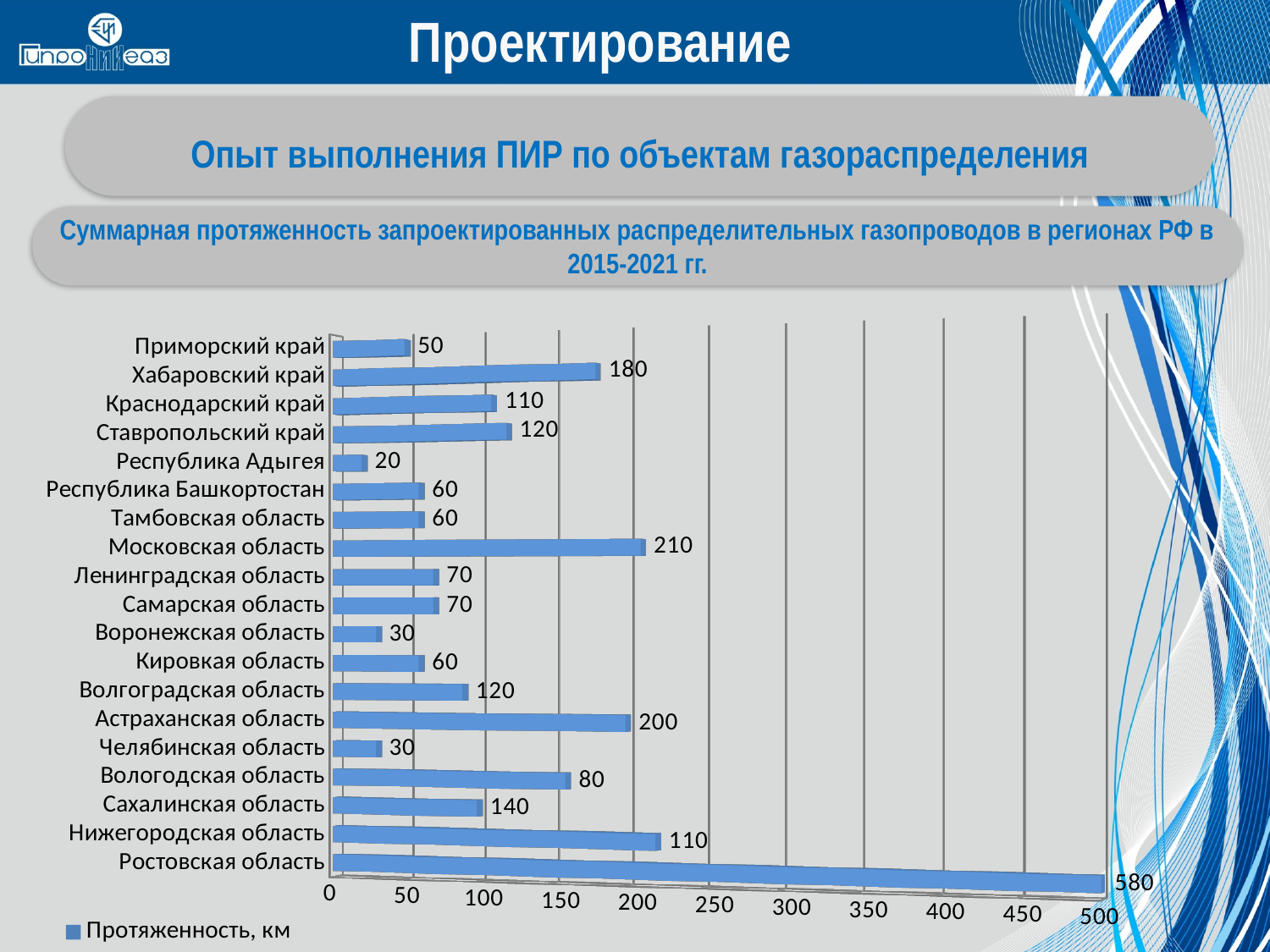
What is the value for Московская область? 210 Which region has the highest value? Ростовская область How many regions are shown in the chart? 19 What kind of chart is shown on the slide? bar chart What is the value for Хабаровский край? 180 What is the value for Республика Адыгея? 20 What is the difference between the values for Хабаровский край and Приморский край? 130 How many series does the legend list? 1 Which region has the lowest value? Республика Адыгея Which is larger, the value for Хабаровский край or Краснодарский край? Хабаровский край What is the value for Ростовская область? 580 Is the value for Астраханская область greater or less than 150? greater